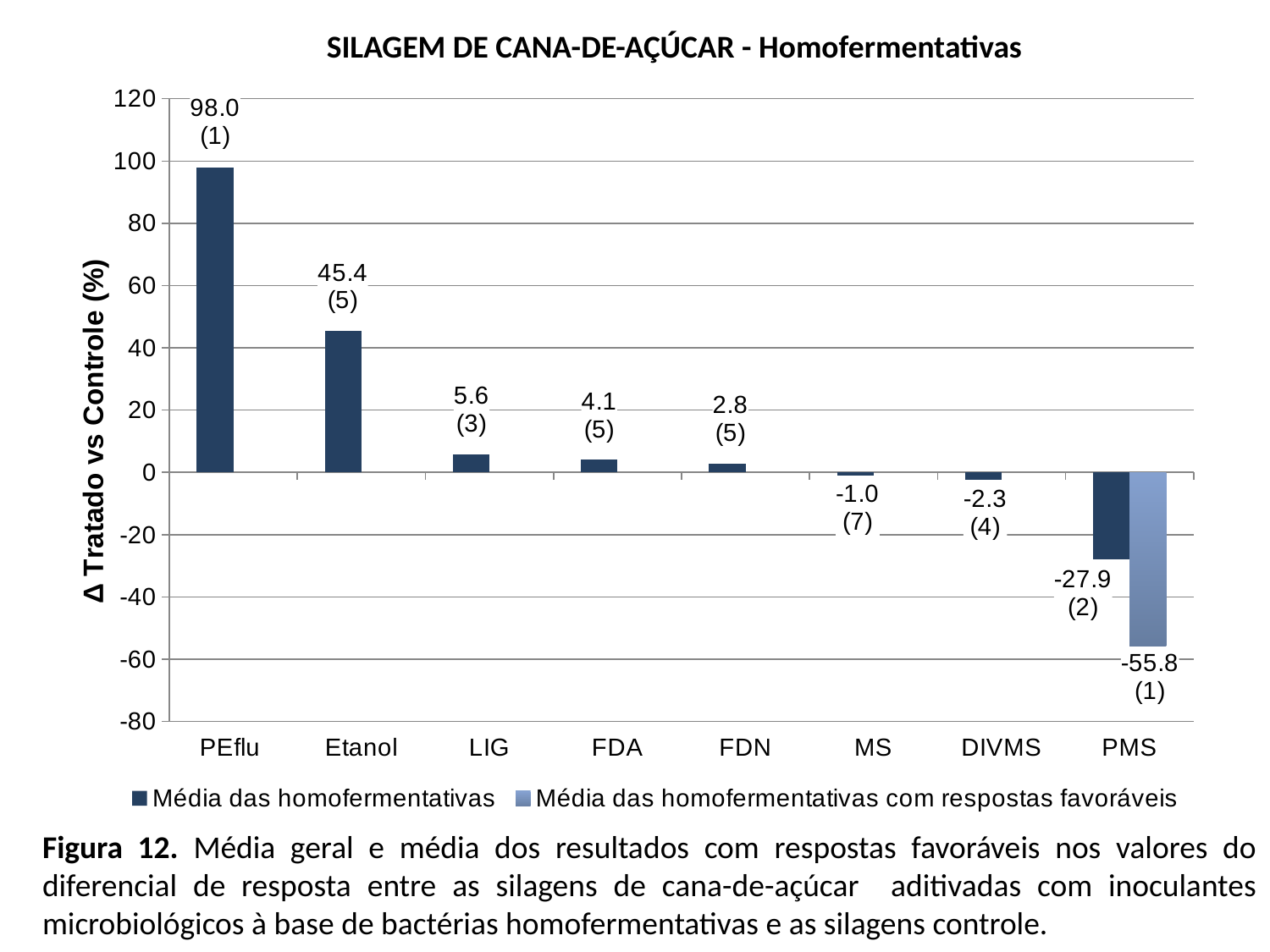
What is the value for PEflu in the 'Média das homofermentativas' series? 98.0 What is the title of the chart? SILAGEM DE CANA-DE-AÇÚCAR - Homofermentativas Which category has the lowest value in the 'Média das homofermentativas' series? PMS What is the value for Etanol in the 'Média das homofermentativas' series? 45.4 How many series does the legend list? 2 What is the difference between the PEflu and Etanol values in the 'Média das homofermentativas' series? 52.6 Is the value for Etanol in the 'Média das homofermentativas' series greater or less than 40? greater What is the value for PMS in the 'Média das homofermentativas com respostas favoráveis' series? -55.8 Which is larger in the 'Média das homofermentativas' series, LIG or FDN? LIG Which category has the highest value in the 'Média das homofermentativas' series? PEflu How many categories are shown on the x axis? 8 What kind of chart is shown on the slide? Bar chart